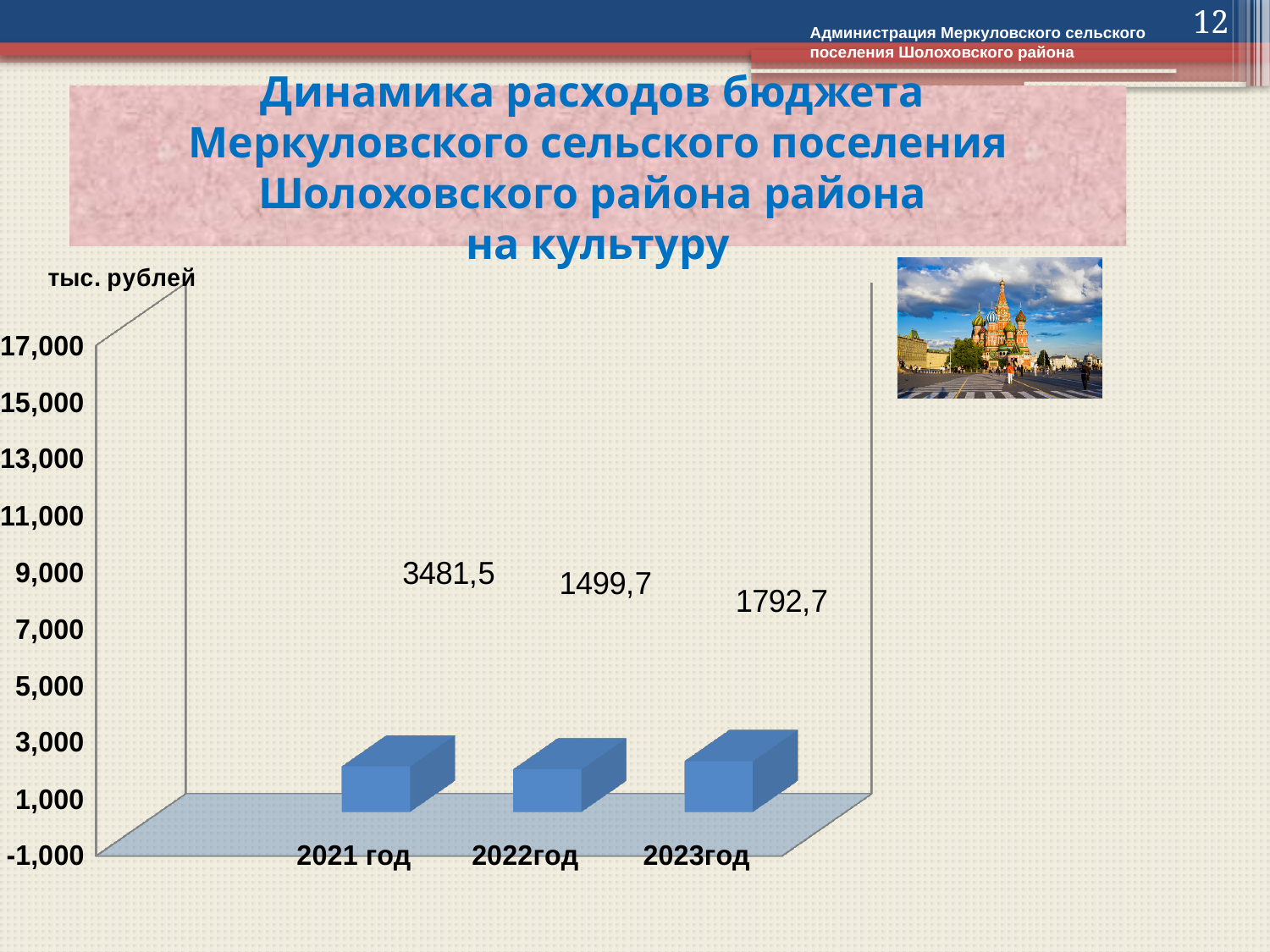
Which year has the lowest value? 2022год What is the value for 2021 год? 3481,5 What is the value for 2023год? 1792,7 Which is larger, the value for 2023год or the value for 2022год? 2023год What is the difference between the values for 2023год and 2022год? 293 How many years are shown on the chart? 3 What is the value for 2022год? 1499,7 What kind of chart is shown on the slide? bar chart What unit is indicated above the vertical axis of the chart? тыс. рублей